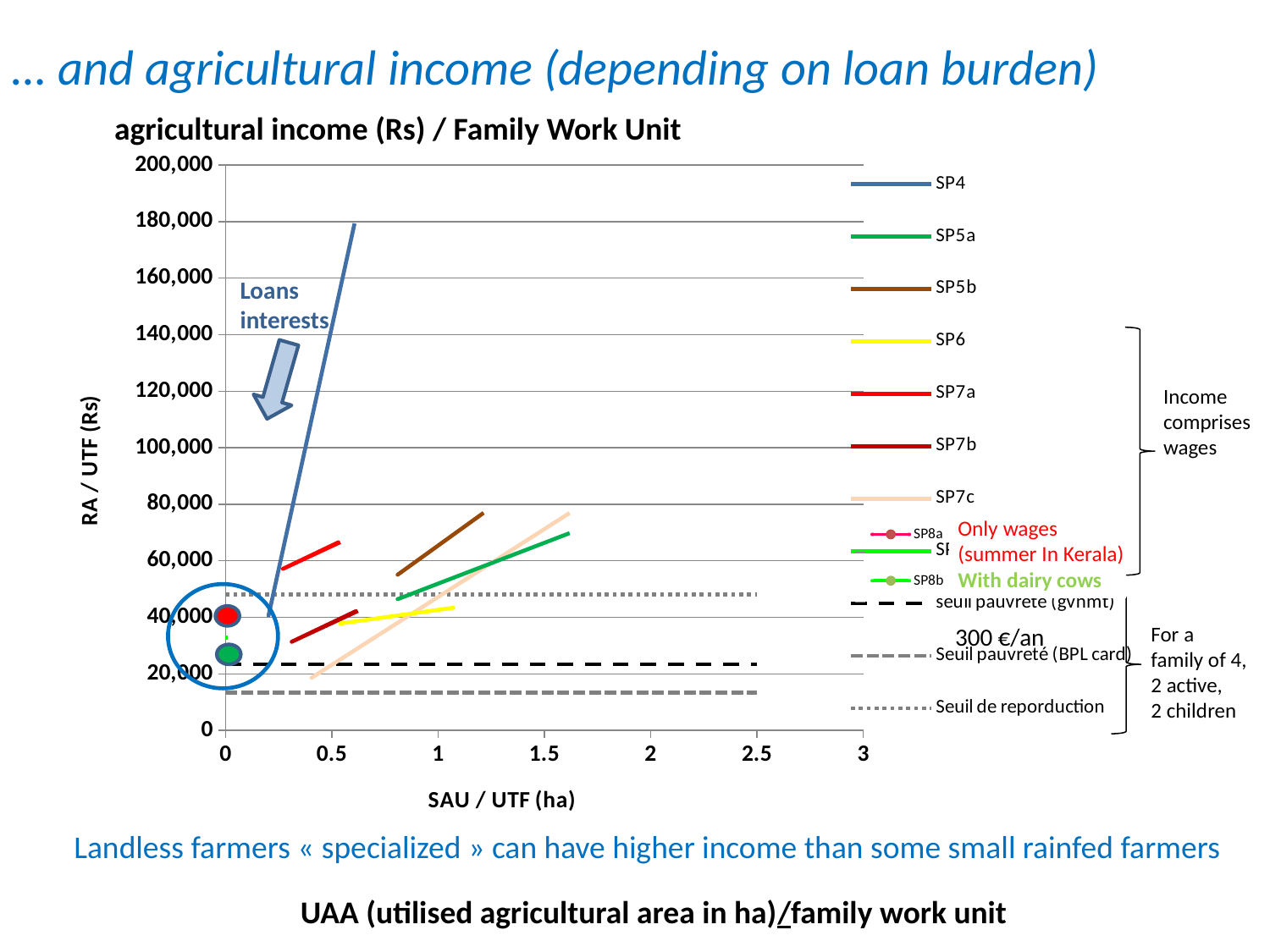
Is the highest point of the SP5b line greater or less than 60,000? greater What is the label of the vertical axis of the chart? RA / UTF (Rs) Is the Seuil pauvreté (BPL card) line greater or less than 20,000? less Which is higher on the chart, the Seuil de reproduction line or the Seuil pauvreté (BPL card) line? Seuil de reproduction Does the SP4 line rise or fall as SAU / UTF (ha) increases? rise Which series reaches the highest agricultural income on the chart? SP4 Which of the three threshold lines (seuil pauvreté (gvnmt), Seuil pauvreté (BPL card), Seuil de reproduction) is the lowest on the chart? Seuil pauvreté (BPL card) Is the Seuil de reproduction line greater or less than 60,000? less What is the title of the chart? agricultural income (Rs) / Family Work Unit What kind of chart is shown on the slide? line chart Which reaches a higher income, the SP4 line or the SP5b line? SP4